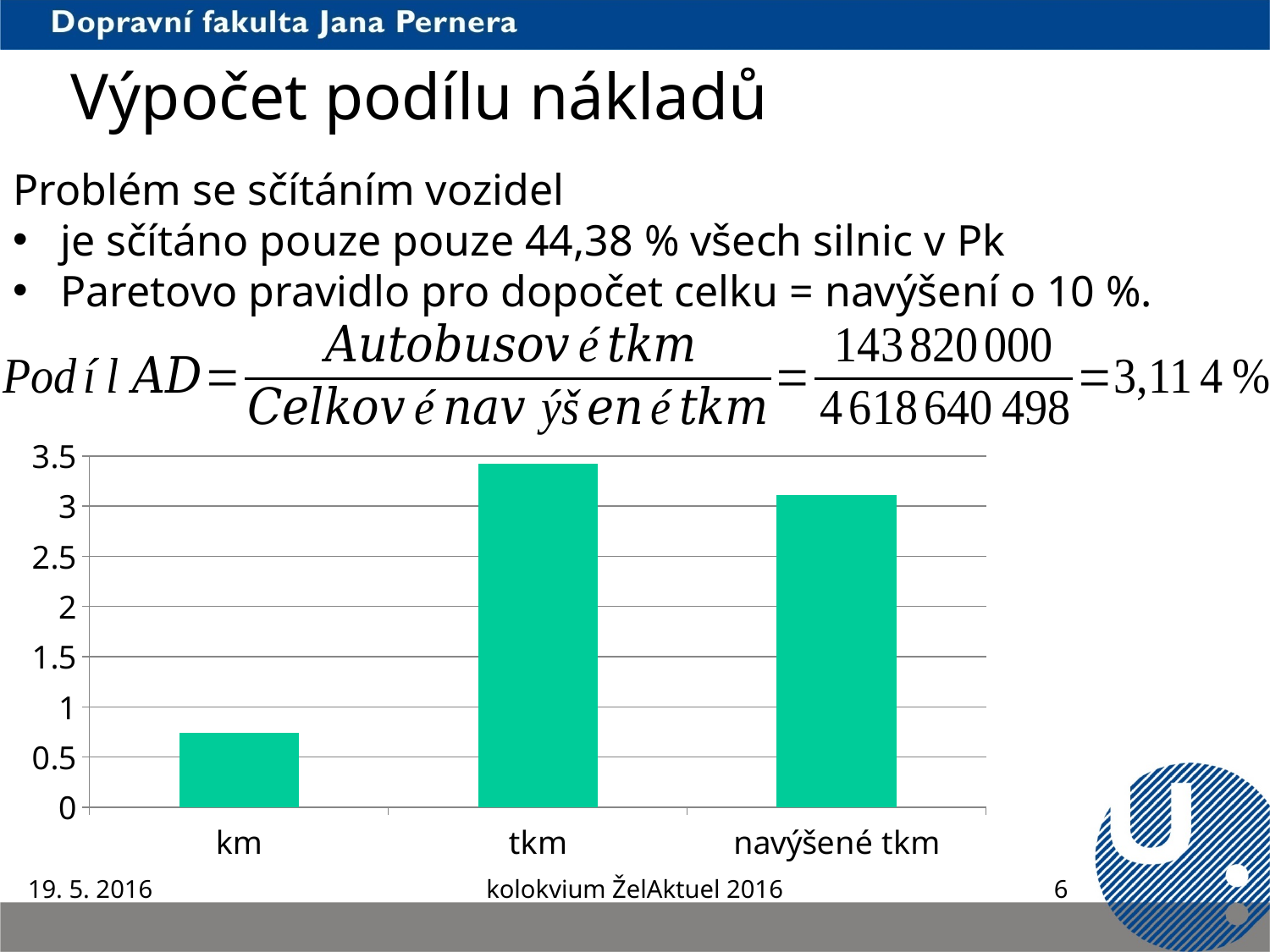
How many categories are shown on the x axis of the chart? 3 Is the value for km greater or less than 1? less What is the label of the third category on the x axis of the chart? navýšené tkm Is the value for navýšené tkm greater or less than 2.5? greater Which category has the lowest bar in the chart? km Is the value for km greater or less than 0.5? greater Which is larger in the chart, the value for km or the value for navýšené tkm? navýšené tkm What kind of chart is shown on the slide? bar chart Which is larger in the chart, the value for tkm or the value for navýšené tkm? tkm What is the highest value shown on the y axis of the chart? 3.5 Which category has the highest bar in the chart? tkm